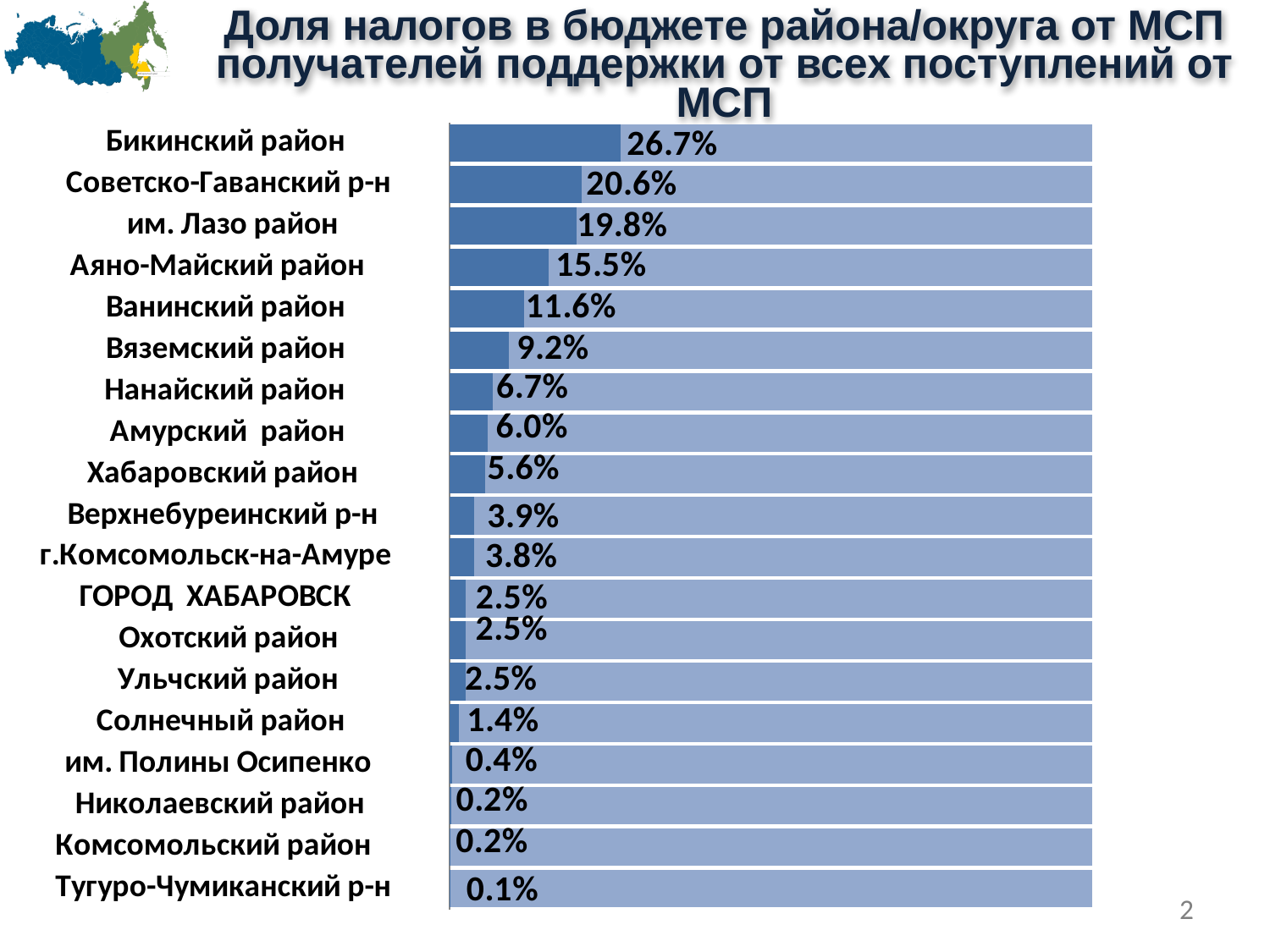
Which is larger, the value for им. Лазо район or the value for Ванинский район? им. Лазо район How many categories are shown in the chart? 19 What is the value for Ванинский район? 11.6% Which category has the highest value? Бикинский район What is the difference between the values for Аяно-Майский район and Вяземский район? 6.3% Do the values rise or fall going from the top category to the bottom category? Fall What is the value for им. Полины Осипенко? 0.4% What is the difference between the values for Бикинский район and Советско-Гаванский р-н? 6.1% What is the value for г.Комсомольск-на-Амуре? 3.8% Which category has the lowest value? Тугуро-Чумиканский р-н What kind of chart is shown on the slide? Bar chart What is the value for Бикинский район? 26.7%